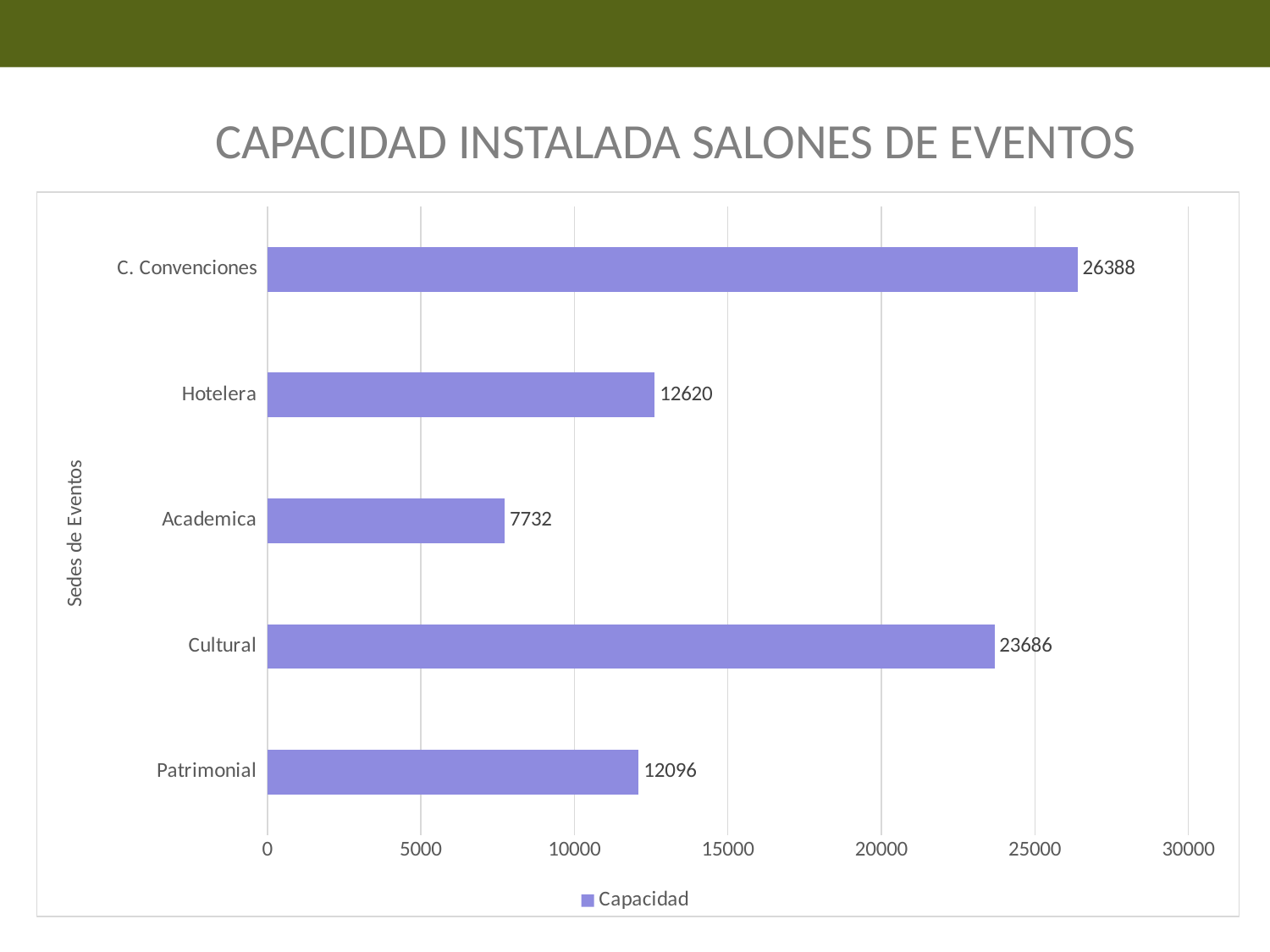
What is the value for C. Convenciones? 26388 Which category has the highest value? C. Convenciones Which is larger, the value for Hotelera or the value for Patrimonial? Hotelera Which category has the lowest value? Academica What is the value for Academica? 7732 What is the title of the chart? CAPACIDAD INSTALADA SALONES DE EVENTOS What is the value for Hotelera? 12620 What kind of chart is shown on the slide? Bar chart What is the value for Cultural? 23686 What is the difference between the values for C. Convenciones and Cultural? 2702 What is the value for Patrimonial? 12096 How many categories are shown on the chart? 5